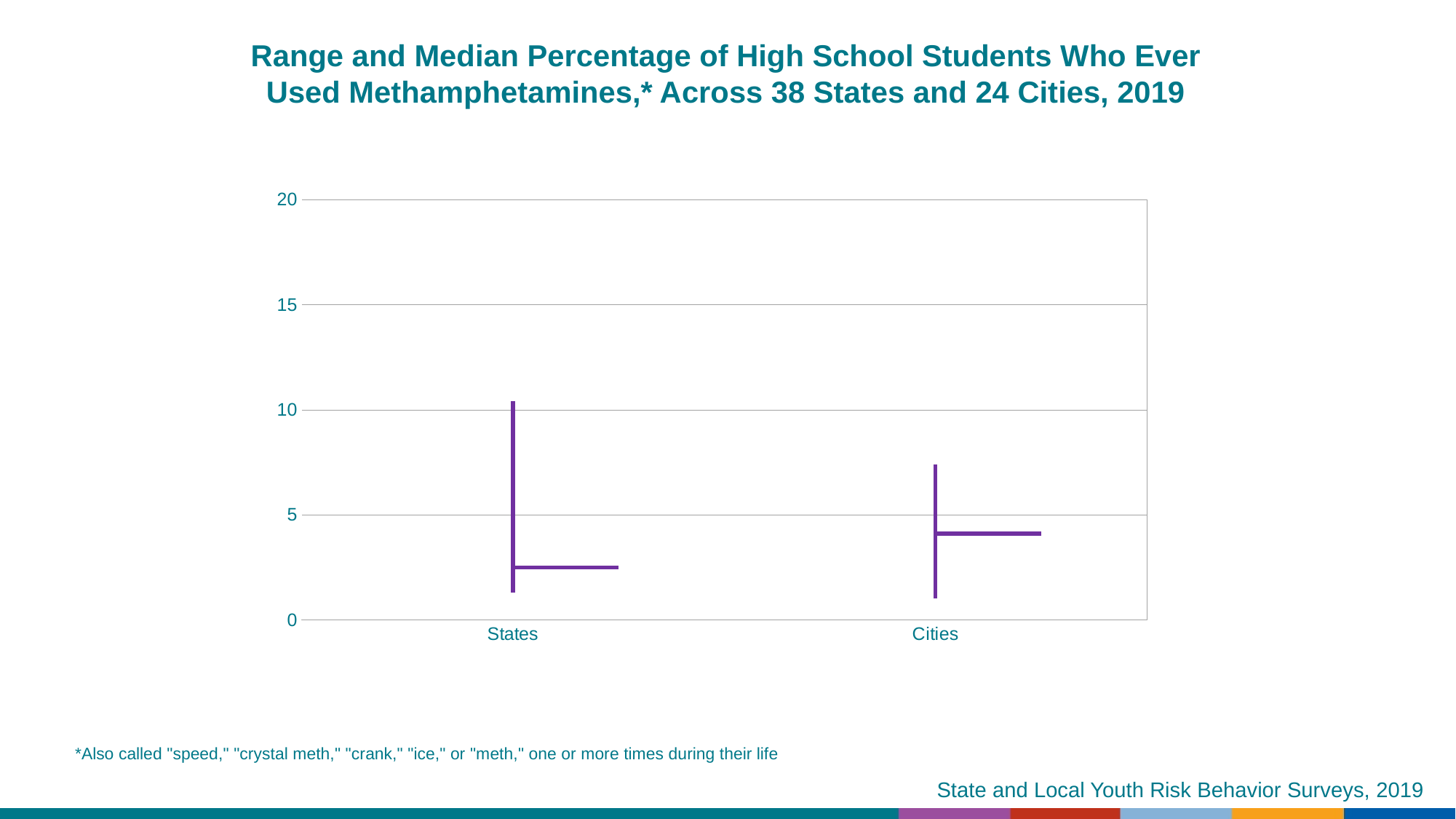
Is the maximum value of the range for Cities greater or less than 10? less Is the median value for Cities greater or less than 5? less How many categories are shown on the x axis of the chart? 2 Is the minimum value of the range for States greater or less than 5? less Which category has the higher maximum (top of the range line), States or Cities? States Which category has the higher median (horizontal marker), States or Cities? Cities What kind of chart is shown on the slide? high-low range chart What are the two categories shown on the x axis? States and Cities What is the highest value shown on the y axis? 20